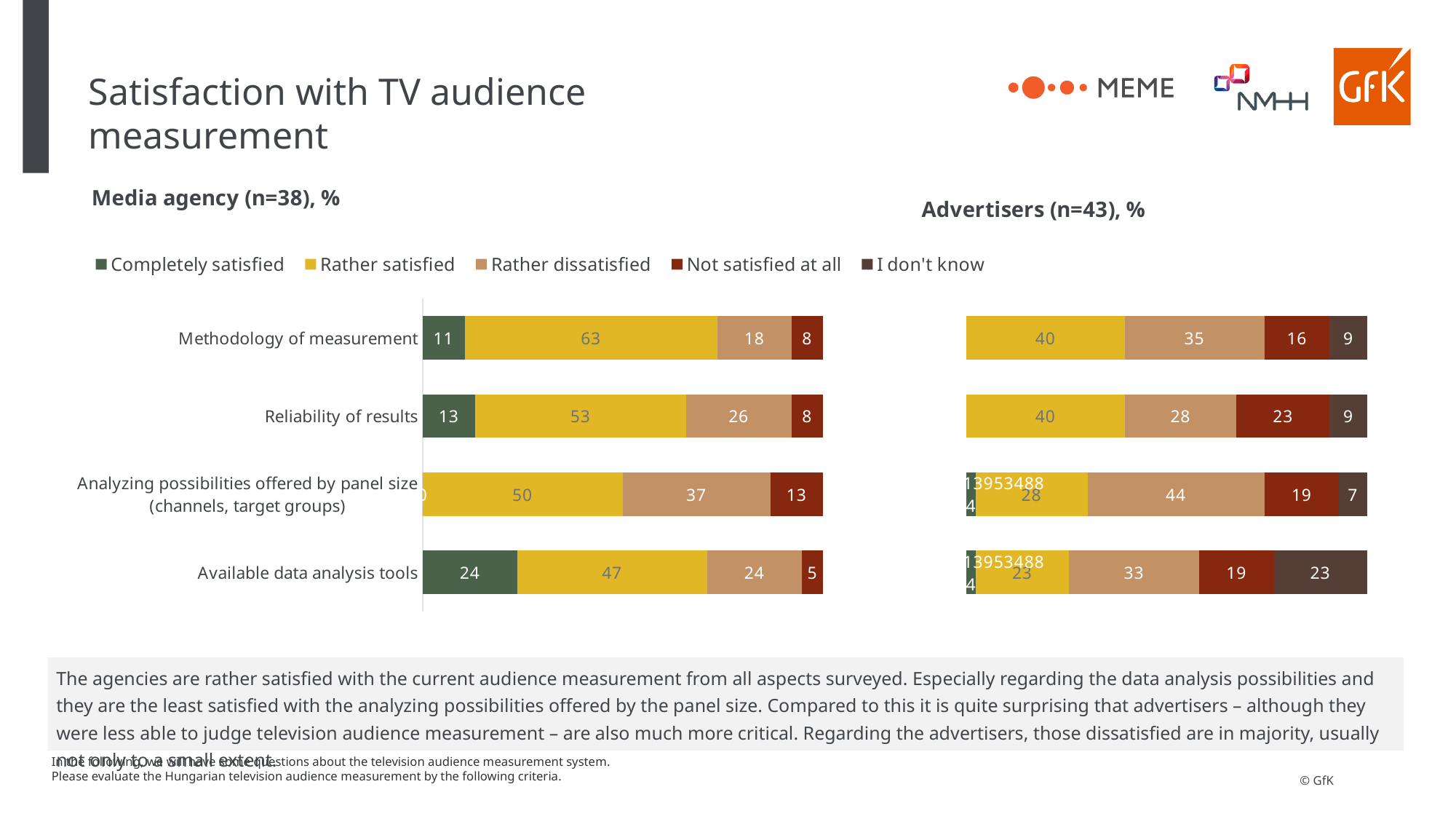
In the Advertisers chart, which is larger for Reliability of results: Rather satisfied or Rather dissatisfied? Rather satisfied What kind of chart is the Media agency chart? Stacked bar chart In the Media agency chart, which category has the lowest Rather satisfied value? Available data analysis tools How many categories are shown in the Media agency chart? 4 In the Advertisers chart, what is the Rather dissatisfied value for Methodology of measurement? 35 In the Media agency chart, which category has the highest Completely satisfied value? Available data analysis tools In the Advertisers chart, what is the total of the Rather satisfied, Rather dissatisfied, Not satisfied at all and I don't know segments for Methodology of measurement? 100 In the Media agency chart, what is the difference between the Rather satisfied values for Methodology of measurement and Reliability of results? 10 In the Media agency chart, what is the Rather satisfied value for Methodology of measurement? 63 In the Media agency chart, what is the Rather dissatisfied value for Analyzing possibilities offered by panel size (channels, target groups)? 37 In the Advertisers chart, what is the Not satisfied at all value for Reliability of results? 23 How many series does the legend list? 5